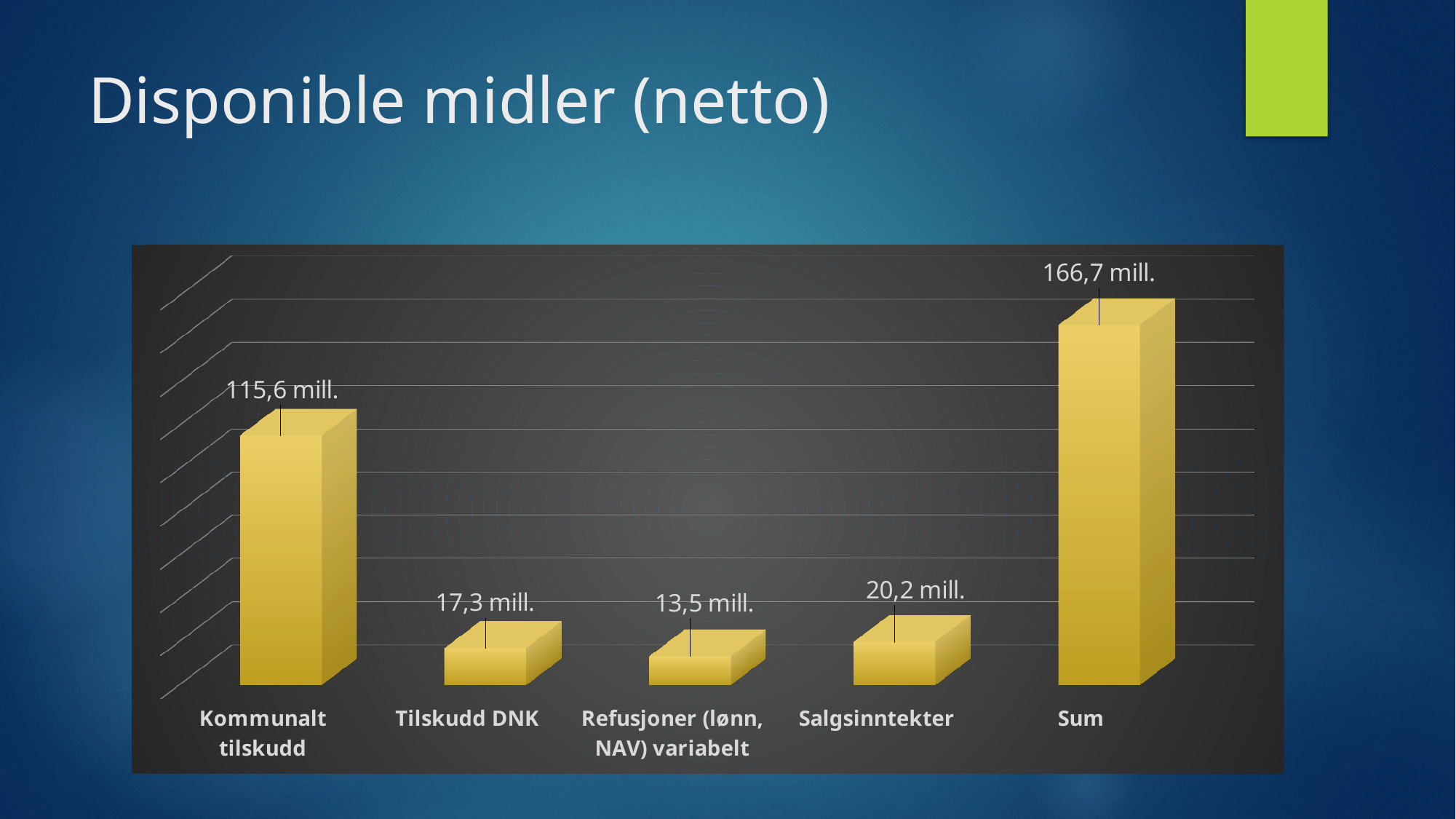
What type of chart is shown on the slide? Bar chart What is the value for Sum? 166,7 mill. What is the value for Salgsinntekter? 20,2 mill. Which category has the highest value? Sum What is the value for Refusjoner (lønn, NAV) variabelt? 13,5 mill. What is the value for Tilskudd DNK? 17,3 mill. How many categories are shown in the chart? 5 Which category has the lowest value? Refusjoner (lønn, NAV) variabelt What is the value for Kommunalt tilskudd? 115,6 mill. What is the difference between Salgsinntekter and Tilskudd DNK? 2,9 mill. What is the difference between Sum and Kommunalt tilskudd? 51,1 mill. Which is larger, Tilskudd DNK or Salgsinntekter? Salgsinntekter